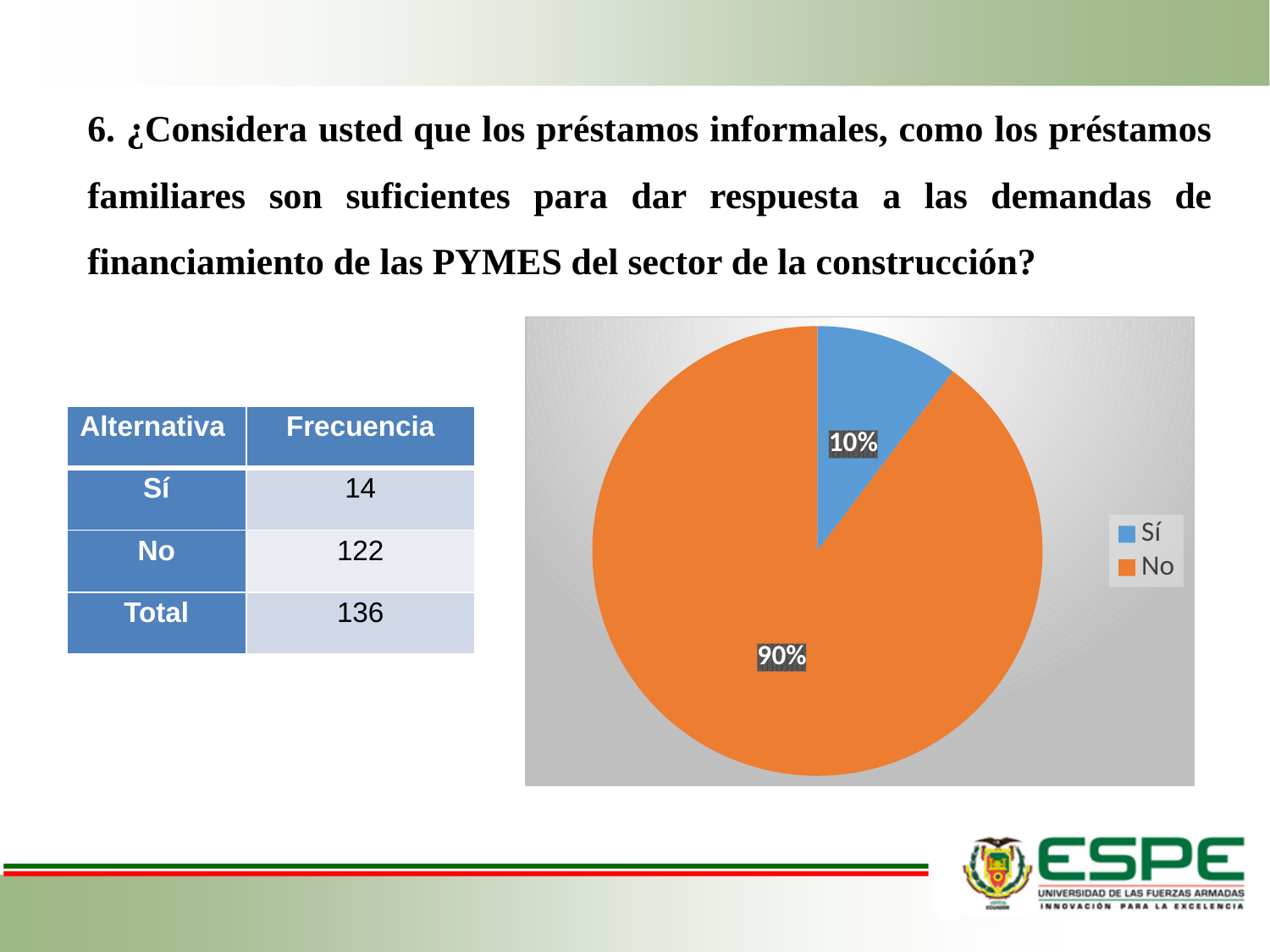
What percentage does the pie chart show for "No"? 90% Which category has the smallest slice in the pie chart? Sí Which slice is larger, "Sí" or "No"? No How many entries does the legend of the pie chart list? 2 What percentage does the pie chart show for "Sí"? 10% What kind of chart is shown on the slide? pie chart What colour is the "Sí" slice in the pie chart? blue How many slices does the pie chart have? 2 What is the difference in percentage points between the "No" and "Sí" slices? 80 What colour is the "No" slice in the pie chart? orange What share of the pie does the "No" slice represent? 90% Which category has the largest slice in the pie chart? No